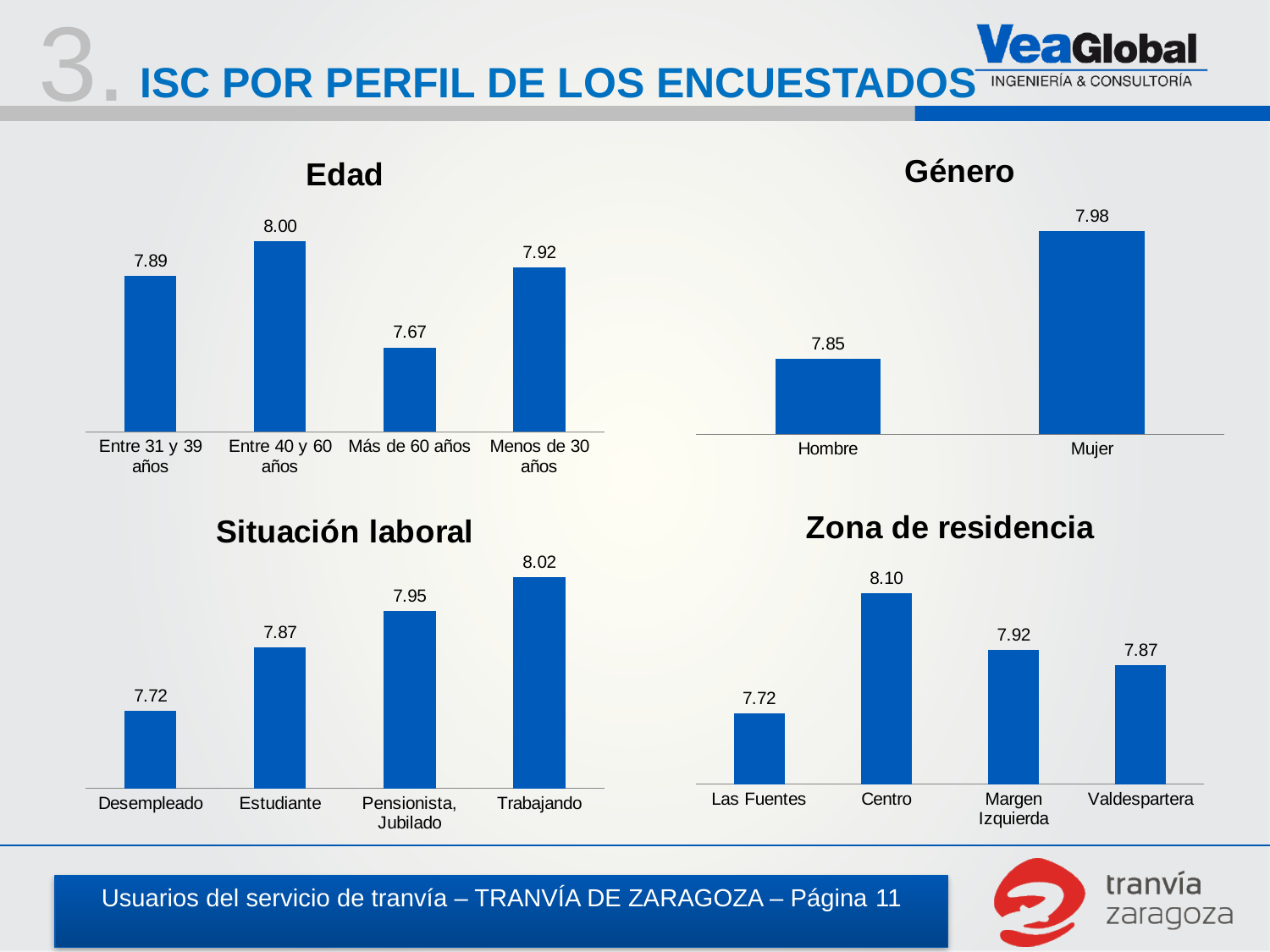
In the 'Zona de residencia' chart, what is the value for 'Centro'? 8.10 In the 'Edad' chart, what is the difference between 'Entre 40 y 60 años' and 'Más de 60 años'? 0.33 In the 'Género' chart, what is the value for 'Mujer'? 7.98 In the 'Situación laboral' chart, which category has the highest value? Trabajando In the 'Género' chart, how many categories are shown? 2 In the 'Situación laboral' chart, do the values rise or fall from left to right? rise In the 'Género' chart, which is larger, 'Hombre' or 'Mujer'? Mujer In the 'Situación laboral' chart, what is the value for 'Desempleado'? 7.72 What kind of chart is the 'Zona de residencia' chart? bar chart In the 'Edad' chart, what is the value for 'Entre 40 y 60 años'? 8.00 In the 'Edad' chart, which category has the lowest value? Más de 60 años In the 'Zona de residencia' chart, what is the difference between 'Centro' and 'Las Fuentes'? 0.38